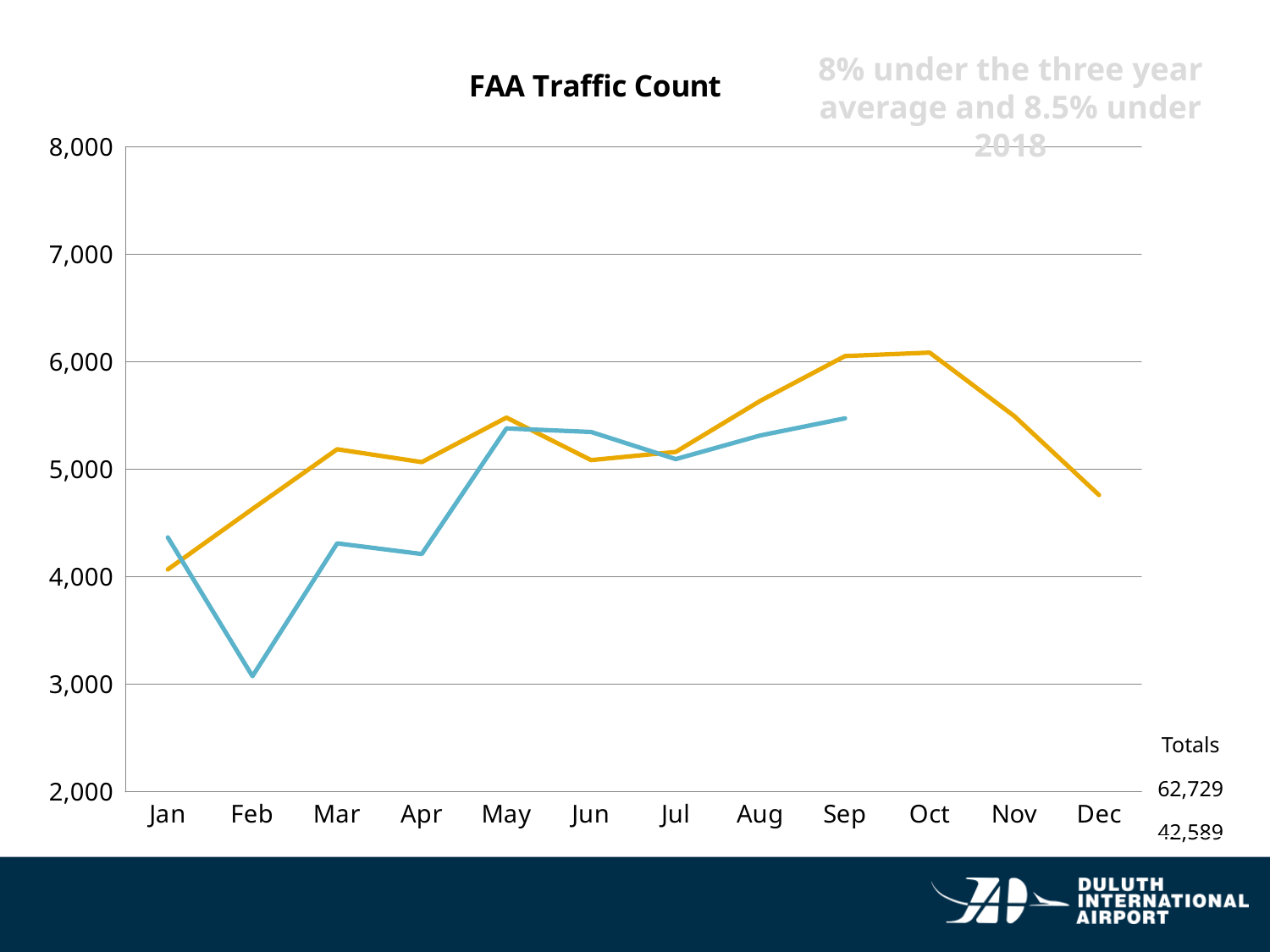
In which month does the blue line reach its lowest value? Feb Is the value of the blue line in Feb greater or less than 4,000? less What kind of chart is shown on the slide? line chart How many months are shown on the x axis of the chart? 12 What is the last month for which the blue line has a data point? Sep Is the value of the orange line in Dec greater or less than 5,000? less In Feb, which line has the higher value, the orange line or the blue line? orange line Is the value of the blue line in May greater or less than 5,000? greater What is the title of the chart? FAA Traffic Count Does the orange line rise or fall from Oct to Dec? fall In which month does the orange line reach its lowest value? Jan